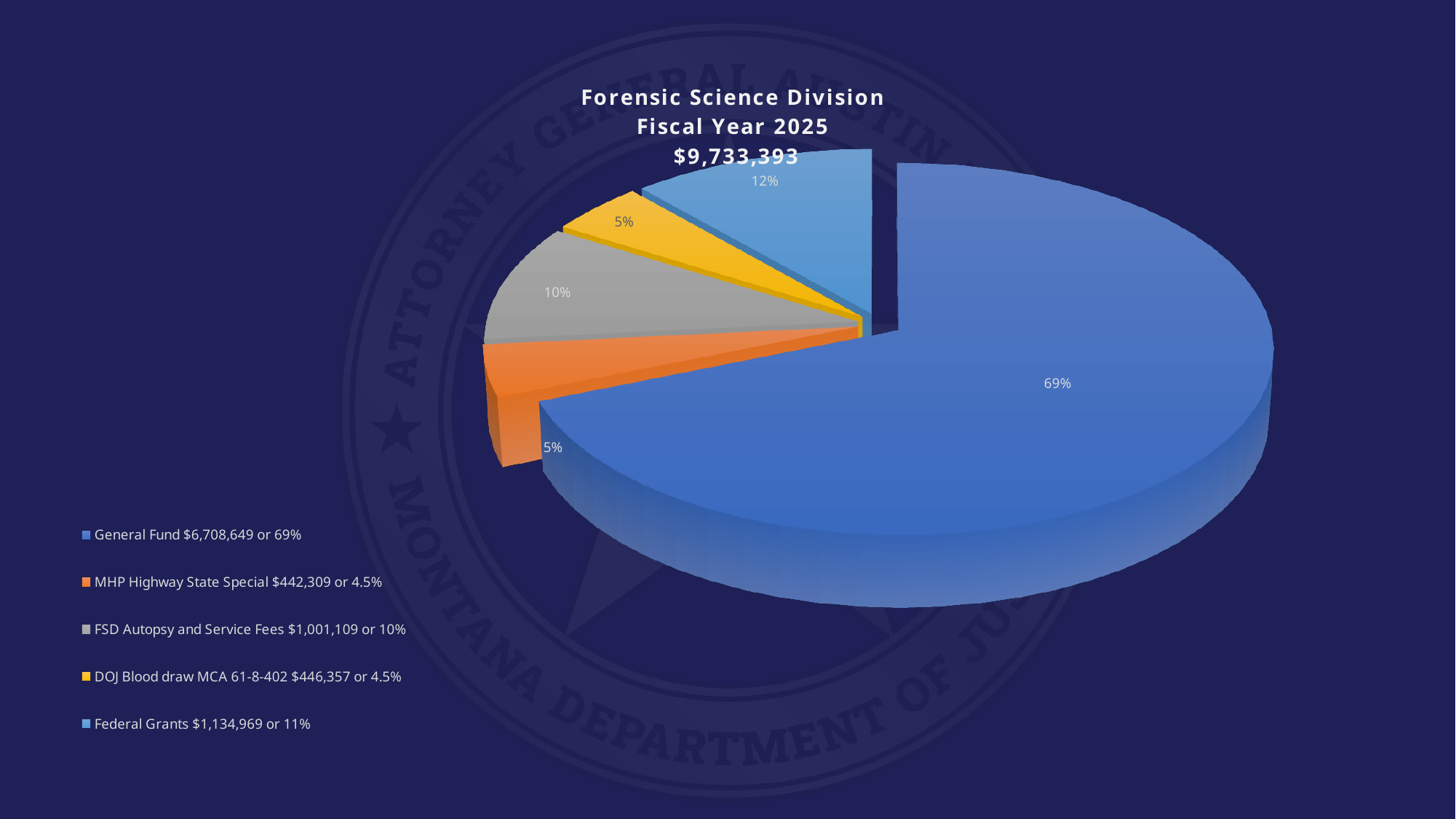
Which fiscal year does the chart title refer to? Fiscal Year 2025 What is the difference in percentage points between the General Fund slice (69%) and the FSD Autopsy and Service Fees slice (10%)? 59 What total dollar amount is shown in the chart title? $9,733,393 Which slice is larger, Federal Grants or FSD Autopsy and Service Fees? Federal Grants What percentage is shown on the FSD Autopsy and Service Fees slice? 10% Which category has the largest slice of the pie? General Fund How many slices does the pie chart have? 5 What percentage is shown on the General Fund slice? 69% According to the legend, what is the dollar amount for MHP Highway State Special? $442,309 What kind of chart is shown on the slide? pie chart According to the legend, what is the dollar amount for the General Fund? $6,708,649 What percentage label is shown on the Federal Grants slice of the pie? 12%